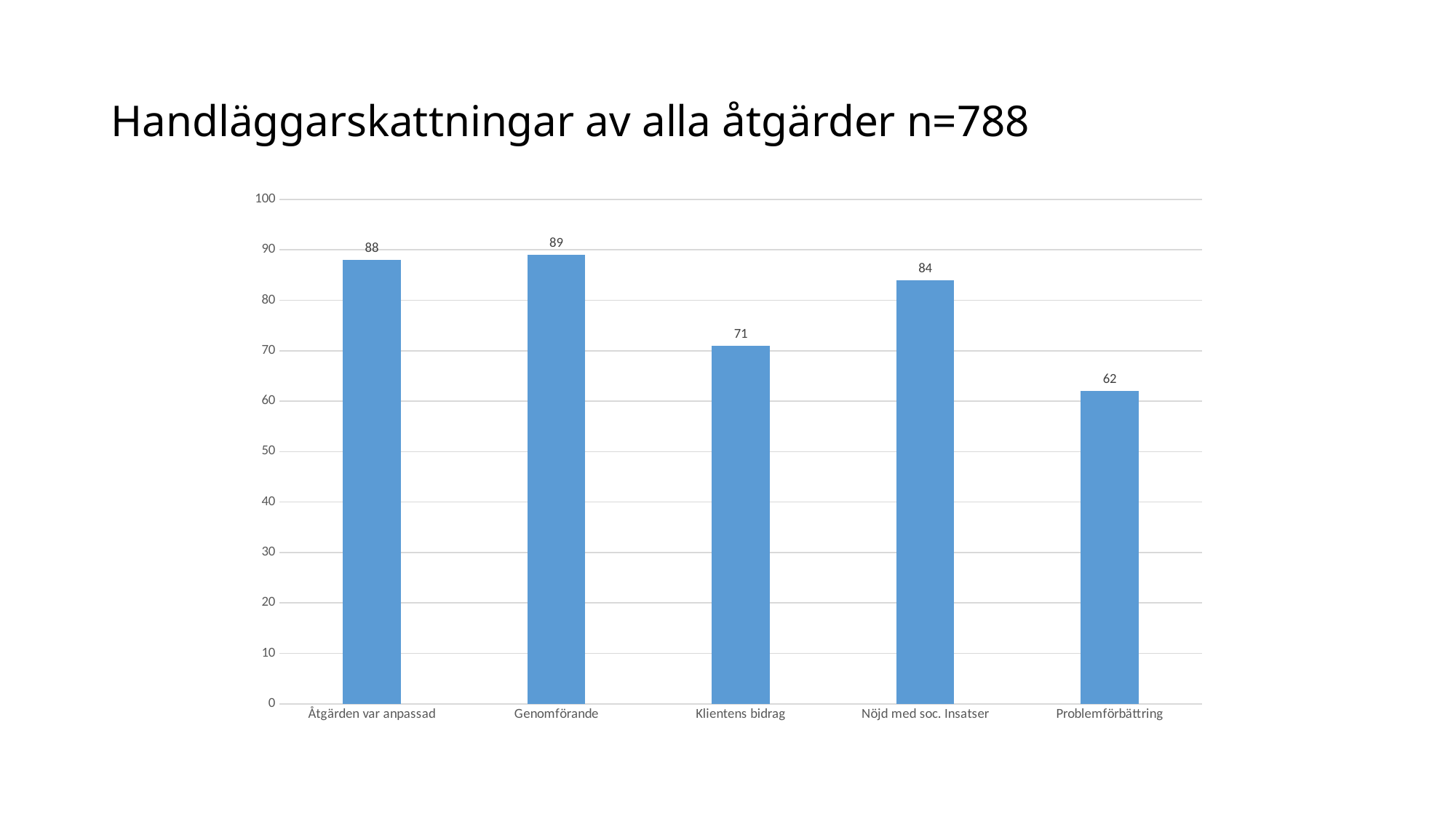
What is the value for Klientens bidrag? 71 What kind of chart is shown on the slide? Bar chart What is the value for Genomförande? 89 What is the title of the slide? Handläggarskattningar av alla åtgärder n=788 What is the value for Åtgärden var anpassad? 88 Which category has the lowest value? Problemförbättring Which category has the highest value? Genomförande Which is larger, the value for Klientens bidrag or the value for Nöjd med soc. Insatser? Nöjd med soc. Insatser How many categories are shown in the chart? 5 What is the difference between the values for Nöjd med soc. Insatser and Problemförbättring? 22 What is the value for Problemförbättring? 62 What is the value for Nöjd med soc. Insatser? 84